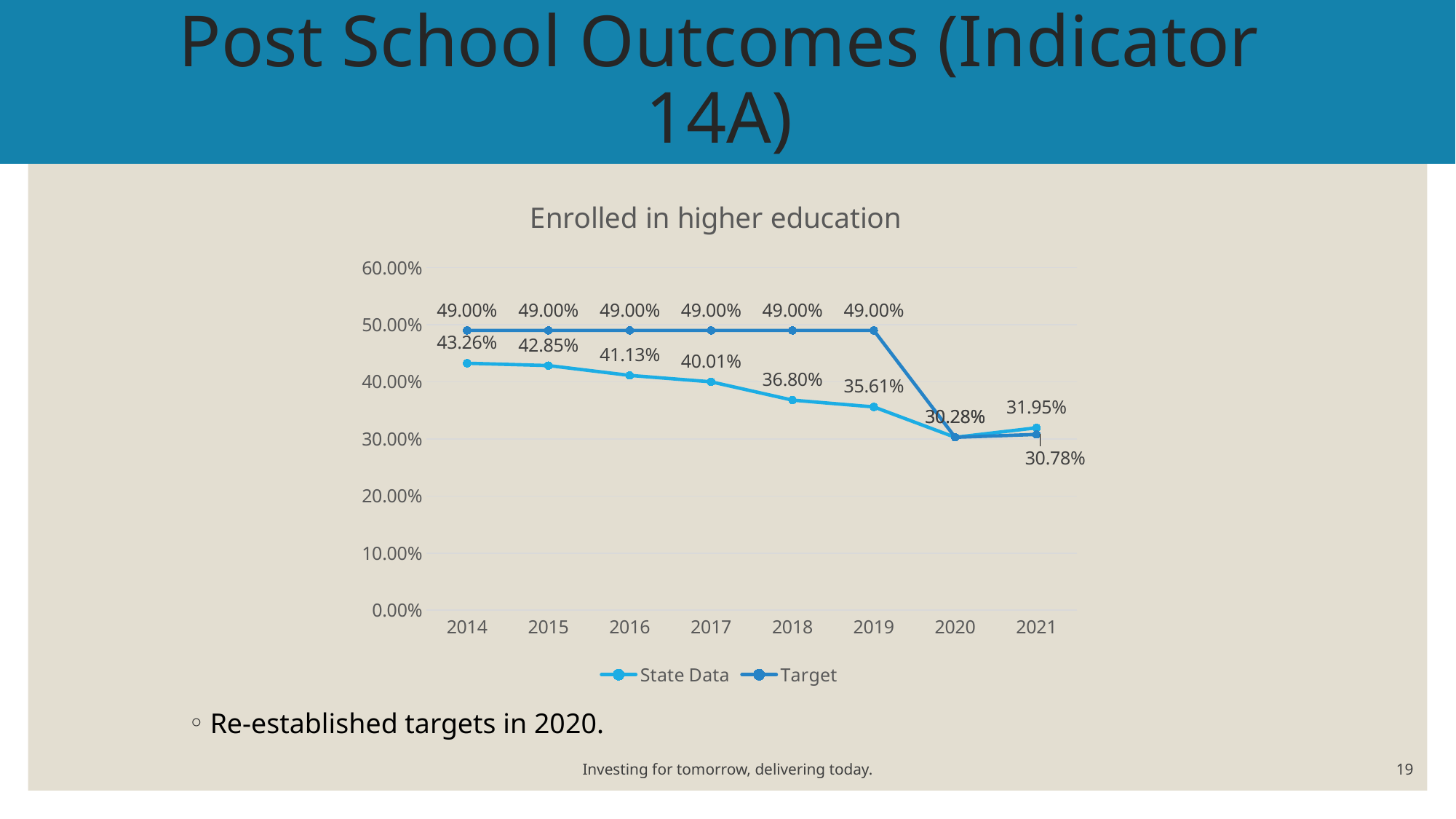
What is the State Data value for 2018? 36.80% By how many percentage points does the Target exceed the State Data in 2014? 5.74 What kind of chart is shown on the slide? Line chart How many series does the legend list? 2 What is the State Data value for 2014? 43.26% In 2021, which is larger: State Data or Target? State Data What is the Target value for 2021? 30.78% Does the State Data value rise or fall from 2014 to 2019? Fall What is the Target value for 2016? 49.00% How many years are plotted along the x axis? 8 What is the State Data value for 2021? 31.95% In which year is the State Data value highest? 2014